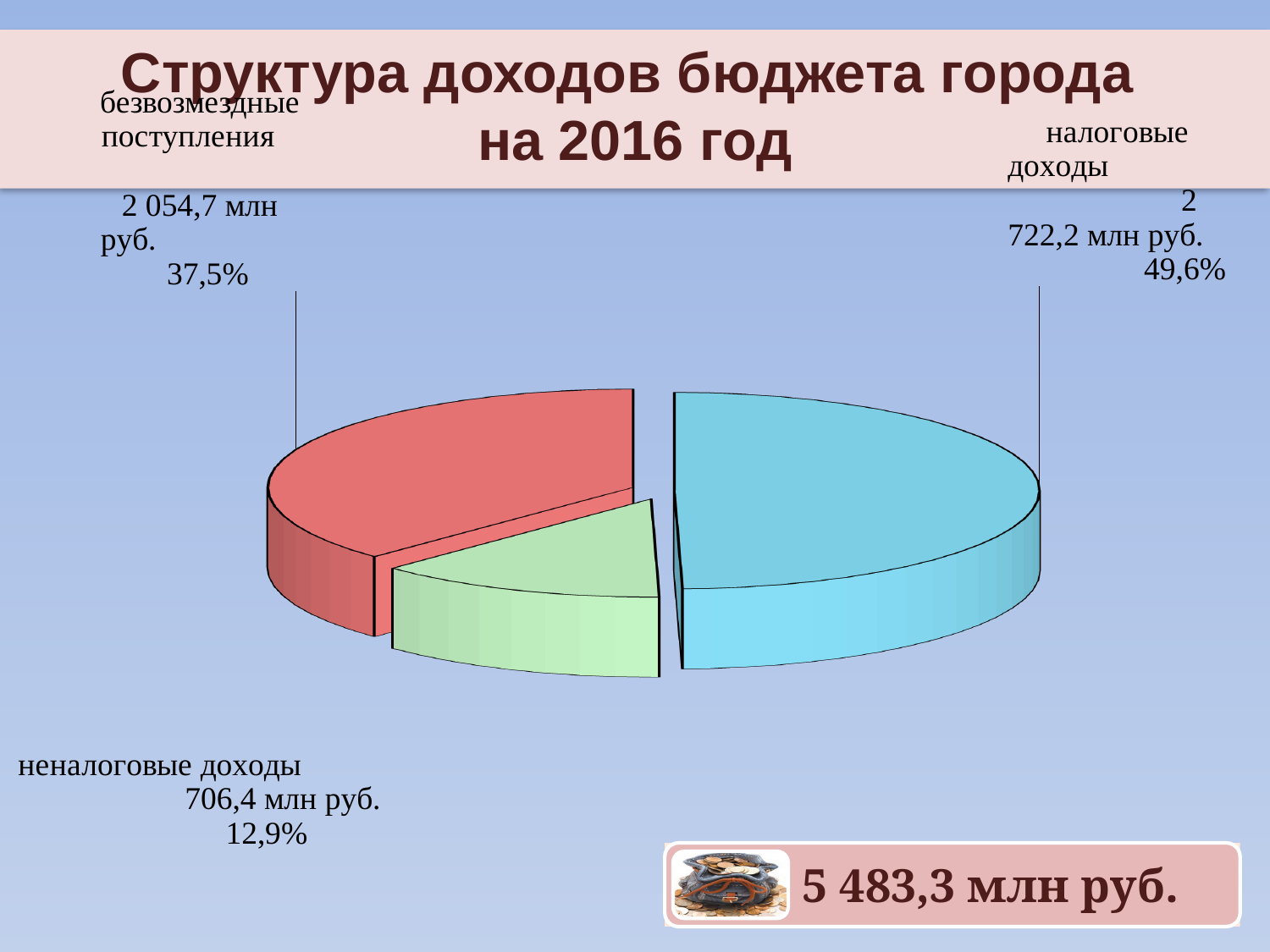
What is the title of the chart? Структура доходов бюджета города на 2016 год How many slices does the pie chart have? 3 What is the value shown for неналоговые доходы? 706,4 млн руб. What is the value shown for налоговые доходы? 2 722,2 млн руб. Which category has the smallest share of the pie? неналоговые доходы What is the value shown for безвозмездные поступления? 2 054,7 млн руб. What percentage share is shown for безвозмездные поступления? 37,5% What percentage share is shown for неналоговые доходы? 12,9% Which category has the largest share of the pie? налоговые доходы What type of chart is shown on the slide? pie chart Which is larger: безвозмездные поступления or неналоговые доходы? безвозмездные поступления What percentage share is shown for налоговые доходы? 49,6%